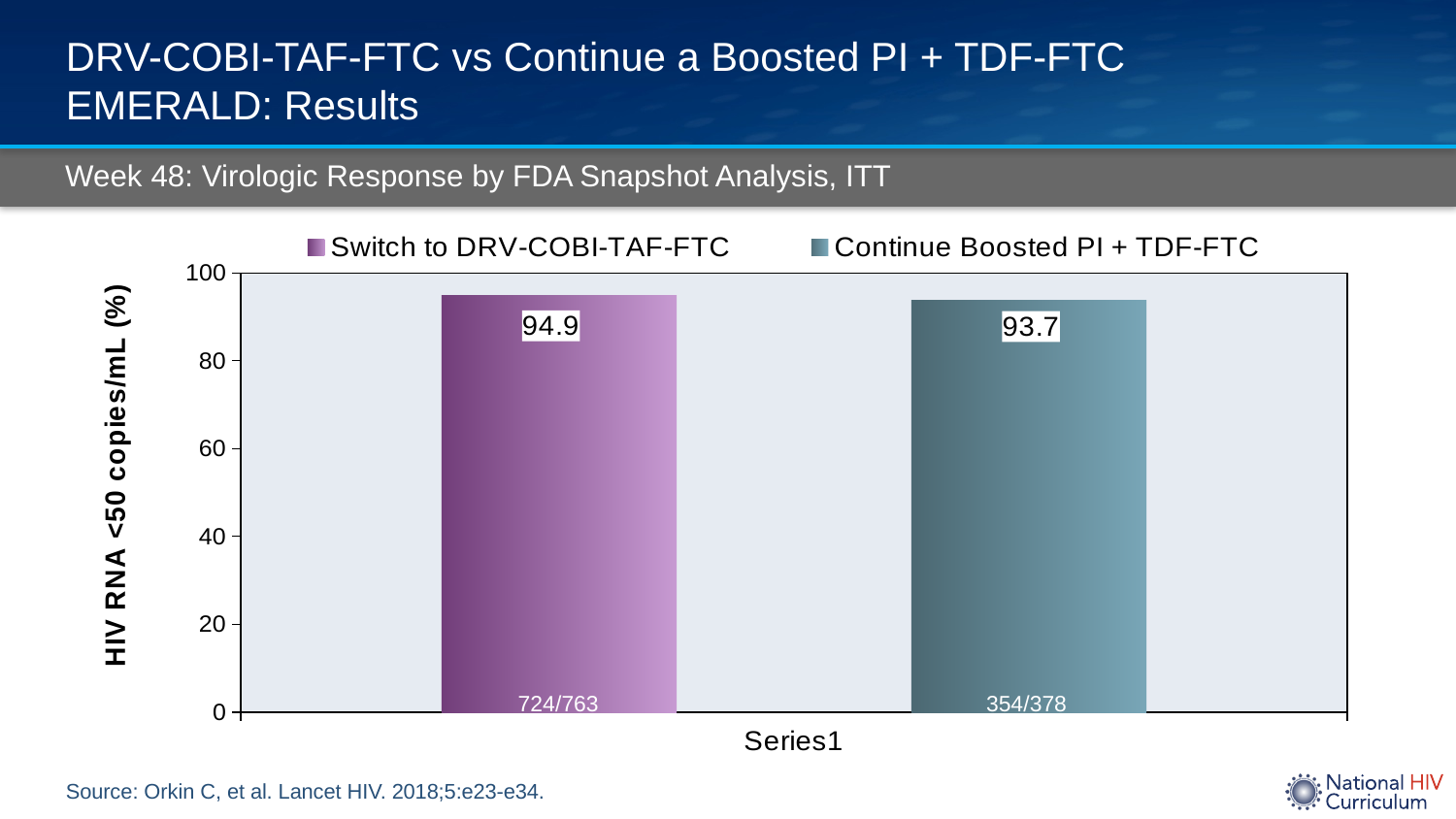
What fraction is printed at the base of the Switch to DRV-COBI-TAF-FTC bar? 724/763 What kind of chart is shown? Bar chart How many series does the legend list? 2 What is the value for Switch to DRV-COBI-TAF-FTC? 94.9 What fraction is printed at the base of the Continue Boosted PI + TDF-FTC bar? 354/378 What is the y-axis label of the chart? HIV RNA <50 copies/mL (%) What is the maximum value shown on the y-axis? 100 What is the difference between the Switch to DRV-COBI-TAF-FTC value and the Continue Boosted PI + TDF-FTC value? 1.2 Which series has the lower value? Continue Boosted PI + TDF-FTC Is the value for Continue Boosted PI + TDF-FTC greater or less than 80? greater Which series has the higher value? Switch to DRV-COBI-TAF-FTC What is the value for Continue Boosted PI + TDF-FTC? 93.7